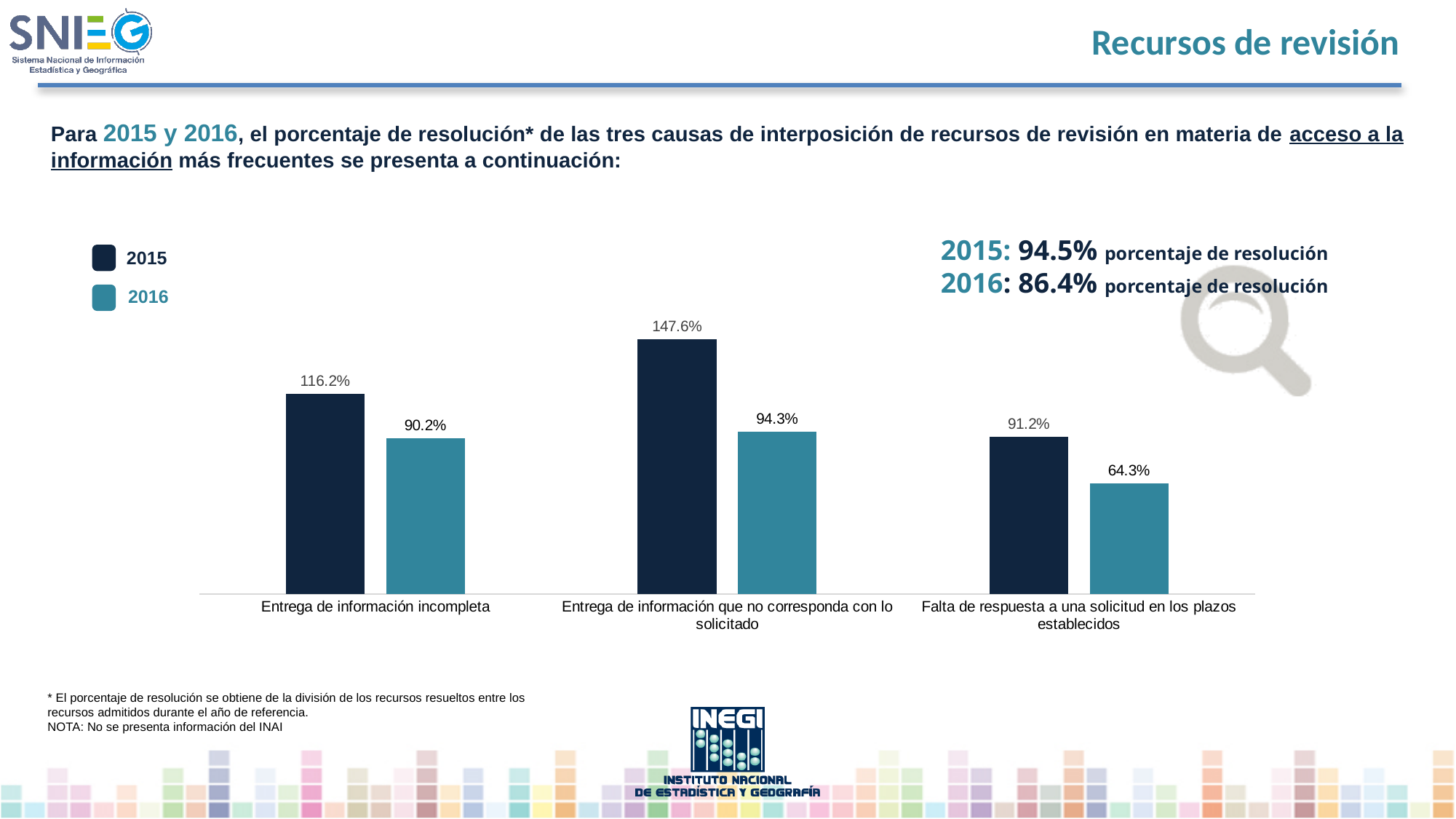
How many categories are shown on the x axis of the chart? 3 Which category has the lowest 2016 value? Falta de respuesta a una solicitud en los plazos establecidos What kind of chart is shown on the slide? Bar chart What is the 2015 value for 'Entrega de información incompleta'? 116.2% How many series does the legend list? 2 What is the difference between the 2015 and 2016 values for 'Entrega de información incompleta'? 26.0 percentage points Which colour represents the 2016 series in the chart? Teal blue Which is larger: the 2015 value for 'Falta de respuesta a una solicitud en los plazos establecidos' or the 2016 value for 'Entrega de información que no corresponda con lo solicitado'? 2016 value for 'Entrega de información que no corresponda con lo solicitado' What is the difference between the 2015 and 2016 values for 'Falta de respuesta a una solicitud en los plazos establecidos'? 26.9 percentage points What is the 2016 value for 'Falta de respuesta a una solicitud en los plazos establecidos'? 64.3% What is the 2016 value for 'Entrega de información que no corresponda con lo solicitado'? 94.3% Which category has the highest 2015 value? Entrega de información que no corresponda con lo solicitado